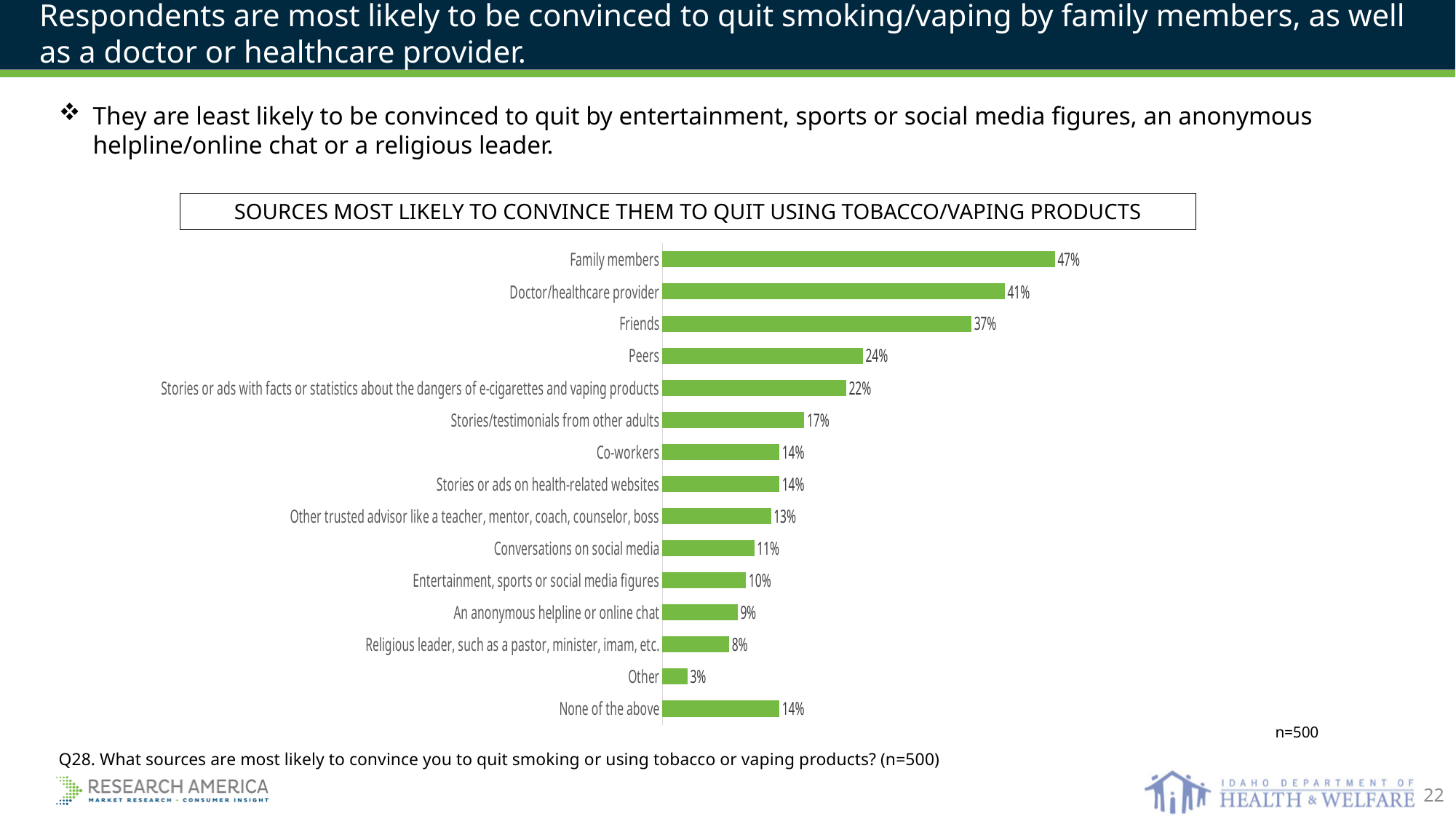
What type of chart is shown on the slide? Bar chart What percentage of respondents said family members are most likely to convince them to quit? 47% Which is larger, the value for Peers or the value for Co-workers? Peers What is the difference between the values for Family members and Friends? 10% What is the value for None of the above? 14% What is the title of the chart? SOURCES MOST LIKELY TO CONVINCE THEM TO QUIT USING TOBACCO/VAPING PRODUCTS How many categories are plotted in the chart? 15 What is the value for Doctor/healthcare provider? 41% Which source has the highest percentage in the chart? Family members What is the difference between the values for Conversations on social media and An anonymous helpline or online chat? 2% Which category has the lowest percentage in the chart? Other What percentage is shown for Religious leader, such as a pastor, minister, imam, etc.? 8%